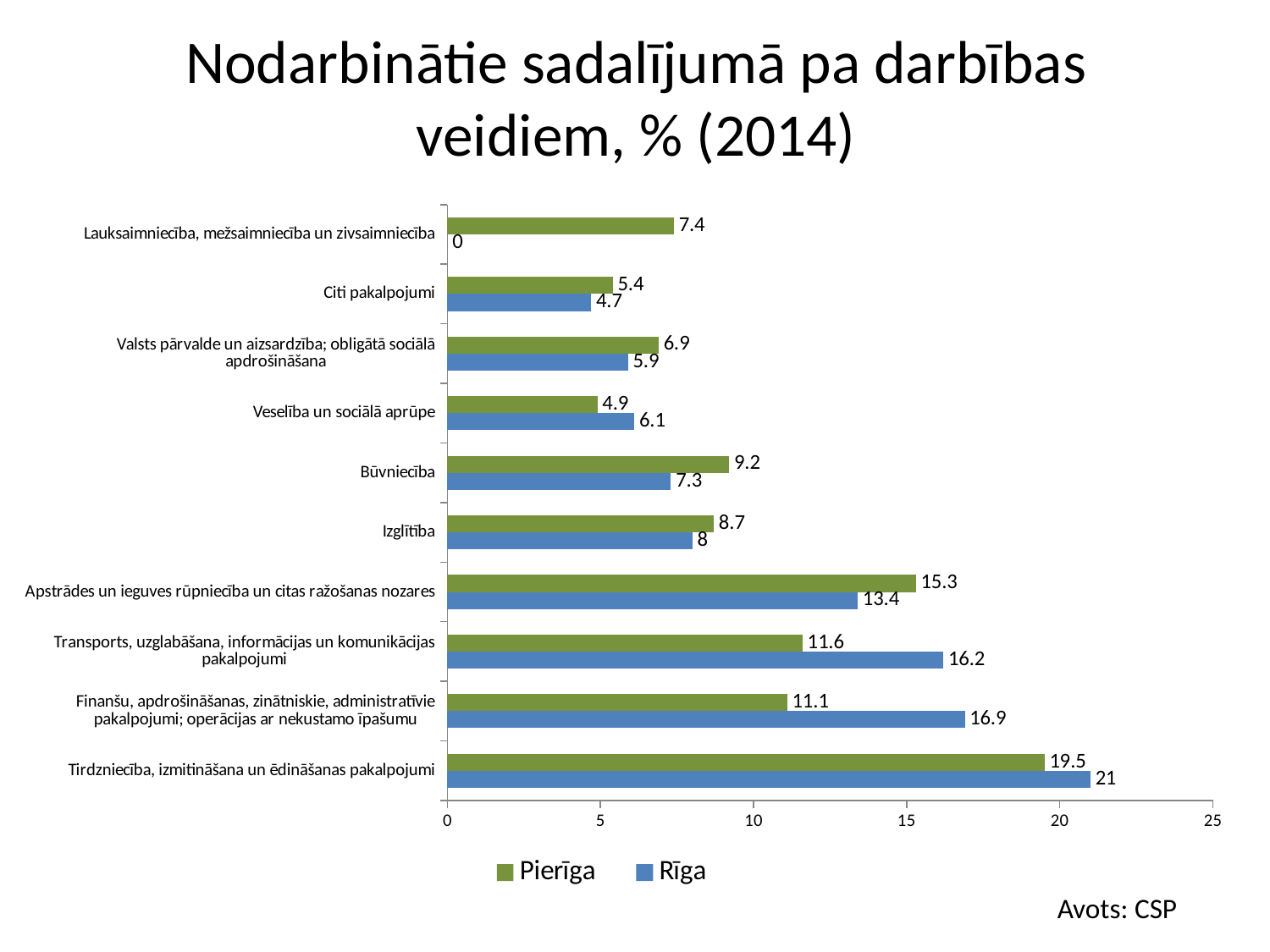
How many series does the legend list? 2 What is the source cited below the chart? CSP Which category has the highest Pierīga value? Tirdzniecība, izmitināšana un ēdināšanas pakalpojumi What is the Rīga value for Tirdzniecība, izmitināšana un ēdināšanas pakalpojumi? 21 Which category has the lowest Rīga value? Lauksaimniecība, mežsaimniecība un zivsaimniecība What is the Pierīga value for Būvniecība? 9.2 How many categories are shown on the chart? 10 What is the difference between the Rīga and Pierīga values for Finanšu, apdrošināšanas, zinātniskie, administratīvie pakalpojumi; operācijas ar nekustamo īpašumu? 5.8 Is the Rīga value for Transports, uzglabāšana, informācijas un komunikācijas pakalpojumi greater or less than 15? greater What is the Rīga value for Lauksaimniecība, mežsaimniecība un zivsaimniecība? 0 What kind of chart is shown on the slide? Bar chart For Veselība un sociālā aprūpe, which series has the larger value, Pierīga or Rīga? Rīga